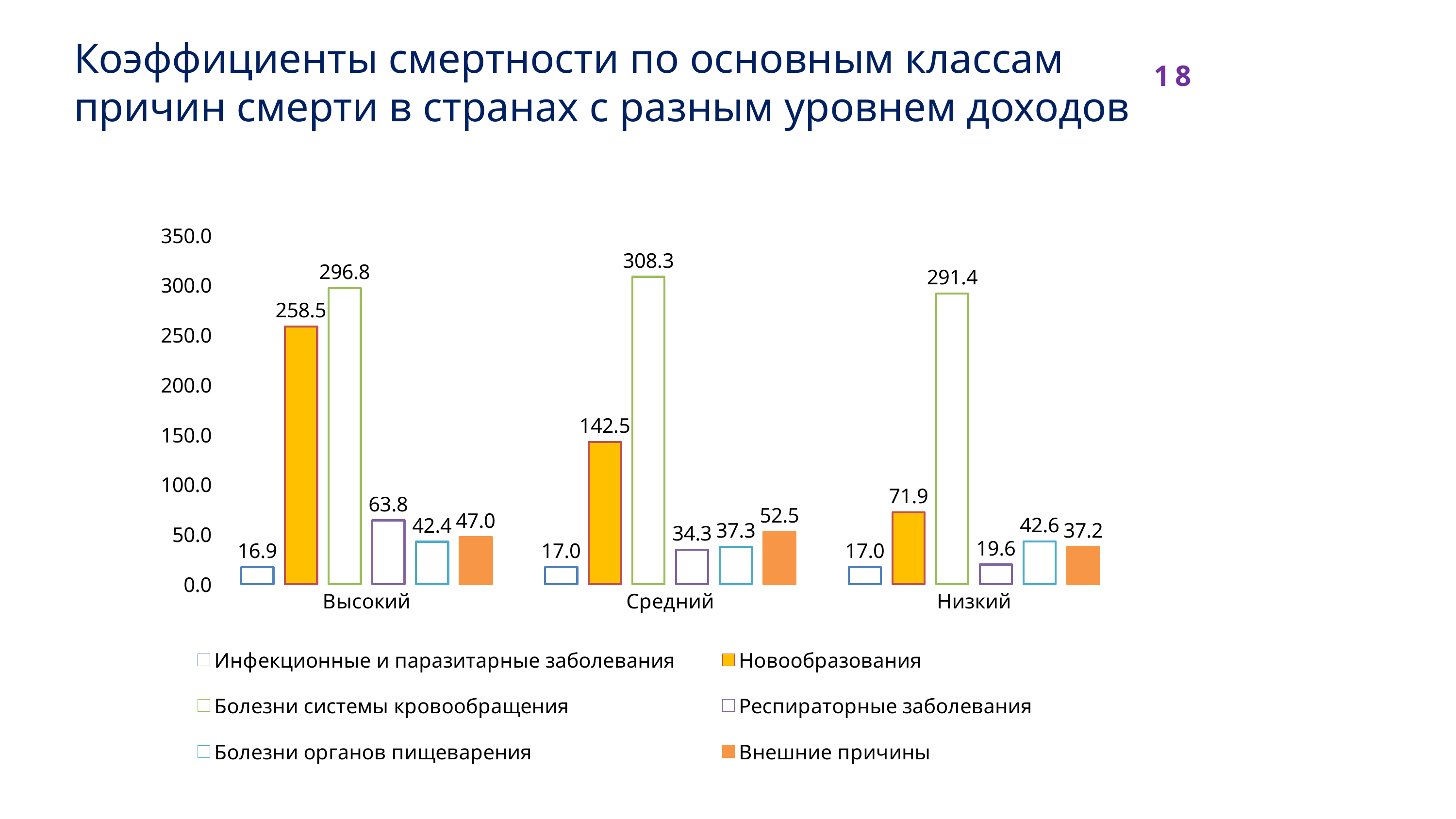
What is the value for Новообразования in the Высокий group? 258.5 Do the values for Новообразования rise or fall going from Высокий to Средний to Низкий? Fall What is the value for Болезни системы кровообращения in the Средний group? 308.3 In the Высокий group, what is the difference between Болезни системы кровообращения and Новообразования? 38.3 Which is larger: Внешние причины in the Средний group or in the Низкий group? Средний In which income group is the value for Болезни системы кровообращения the highest? Средний What is the difference between the Новообразования values for the Высокий and Средний groups? 116.0 In which income group is the value for Респираторные заболевания the lowest? Низкий How many income-level categories are shown on the x axis? 3 How many series does the legend list? 6 What is the value for Болезни органов пищеварения in the Низкий group? 42.6 What kind of chart is shown on the slide? Bar chart